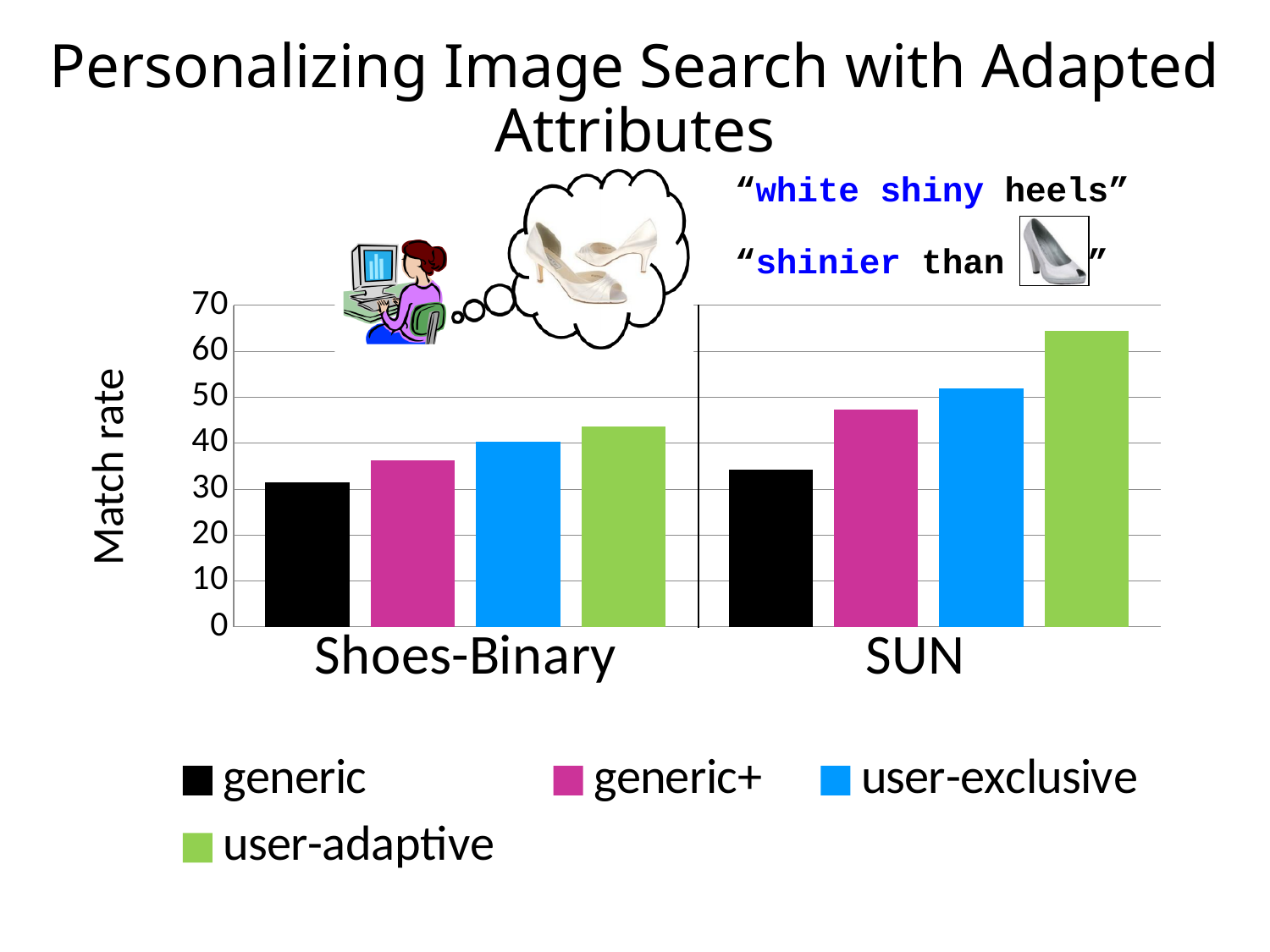
Which series has the highest match rate for SUN? user-adaptive Is the match rate for user-adaptive on SUN greater or less than 60? greater How many series does the legend list? 4 What is the label of the y axis? Match rate How many categories are shown on the x axis? 2 What kind of chart is shown on the slide? bar chart Which series has the lowest match rate for Shoes-Binary? generic Which is larger: the user-adaptive match rate for Shoes-Binary or for SUN? SUN Is the match rate for generic on Shoes-Binary greater or less than 40? less Which is larger for SUN: the generic+ match rate or the generic match rate? generic+ Is the match rate for user-exclusive on SUN greater or less than 50? greater Which colour represents the user-exclusive series? blue